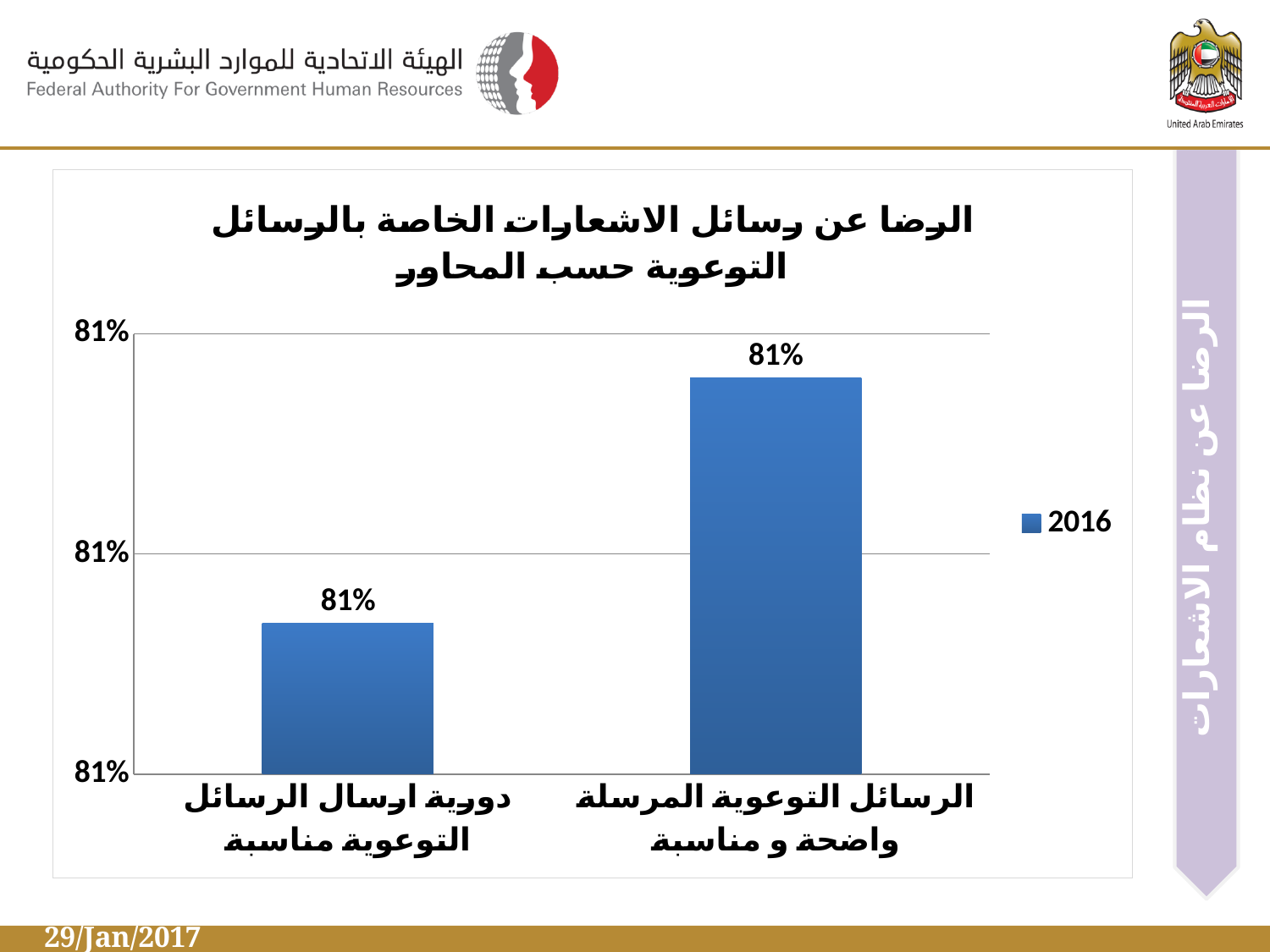
What is the title of the chart? الرضا عن رسائل الاشعارات الخاصة بالرسائل التوعوية حسب المحاور What series name appears in the chart legend? 2016 How many bars are shown in the chart? 2 How many categories are plotted on the chart? 2 What is the value for the category "دورية ارسال الرسائل التوعوية مناسبة"? 81% What kind of chart is shown on the slide? bar chart How many series does the legend list? 1 What value is printed as the data label on the bar for "الرسائل التوعوية المرسلة واضحة و مناسبة"? 81% What is the value for the category "الرسائل التوعوية المرسلة واضحة و مناسبة"? 81%